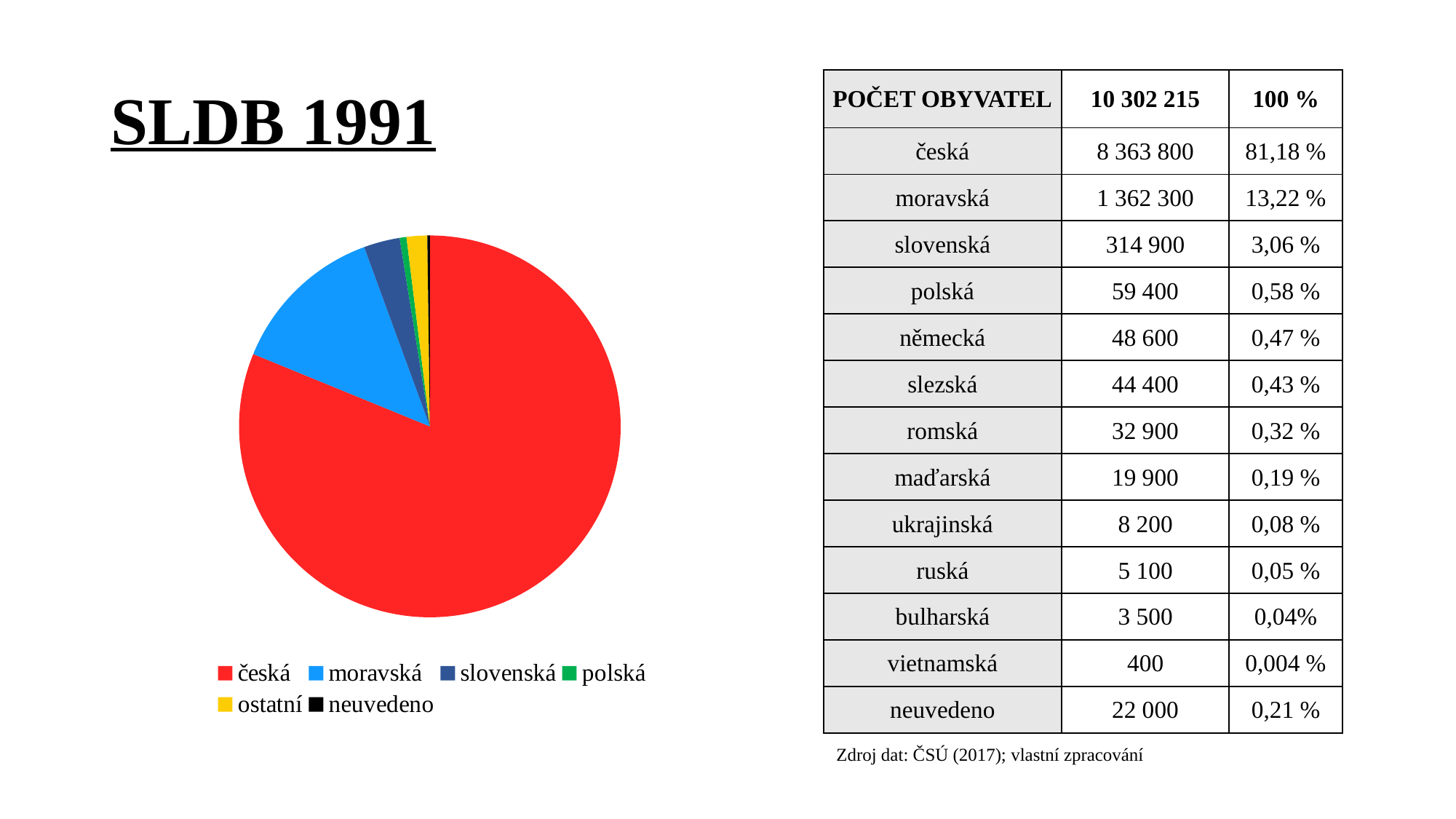
What colour is the česká slice in the pie chart? red How many entries does the pie chart's legend list? 6 According to the table on the slide, what share of the population does the moravská slice represent? 13,22 % Which category has the largest slice in the pie chart? česká Which category has the smallest slice in the pie chart? neuvedeno What kind of chart is shown on the slide? pie chart What is the title shown on the slide above the pie chart? SLDB 1991 Which slice is larger in the pie chart, česká or moravská? česká According to the table on the slide, what share of the population does the česká slice represent? 81,18 % How many slices does the pie chart have? 6 Which slice is larger in the pie chart, slovenská or polská? slovenská Which slice is larger in the pie chart, moravská or slovenská? moravská